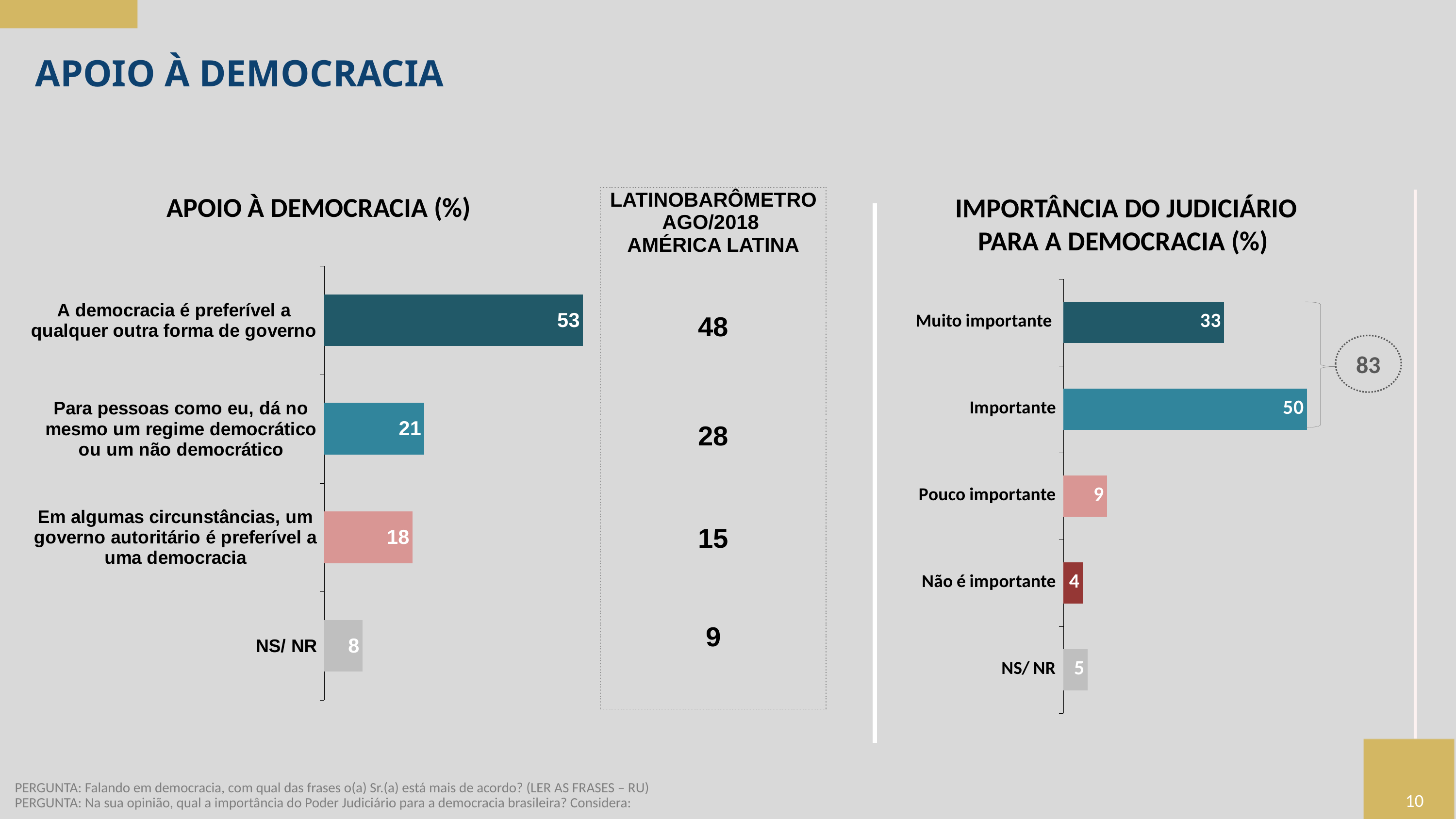
In the chart 'APOIO À DEMOCRACIA (%)', what is the difference between 'Para pessoas como eu, dá no mesmo um regime democrático ou um não democrático' and 'Em algumas circunstâncias, um governo autoritário é preferível a uma democracia'? 3 What kind of chart is 'APOIO À DEMOCRACIA (%)'? Bar chart In the chart 'APOIO À DEMOCRACIA (%)', which category has the lowest value? NS/ NR In the chart 'IMPORTÂNCIA DO JUDICIÁRIO PARA A DEMOCRACIA (%)', what is the value for 'Importante'? 50 In the chart 'IMPORTÂNCIA DO JUDICIÁRIO PARA A DEMOCRACIA (%)', what is the difference between 'Importante' and 'Muito importante'? 17 In the chart 'IMPORTÂNCIA DO JUDICIÁRIO PARA A DEMOCRACIA (%)', how many categories are shown? 5 In the chart 'APOIO À DEMOCRACIA (%)', how many categories are shown? 4 In the chart 'IMPORTÂNCIA DO JUDICIÁRIO PARA A DEMOCRACIA (%)', which is larger: 'Pouco importante' or 'NS/ NR'? Pouco importante In the chart 'APOIO À DEMOCRACIA (%)', what is the value for 'NS/ NR'? 8 In the chart 'IMPORTÂNCIA DO JUDICIÁRIO PARA A DEMOCRACIA (%)', what is the value for 'Não é importante'? 4 In the chart 'APOIO À DEMOCRACIA (%)', what is the value for 'A democracia é preferível a qualquer outra forma de governo'? 53 In the chart 'IMPORTÂNCIA DO JUDICIÁRIO PARA A DEMOCRACIA (%)', which category has the highest value? Importante